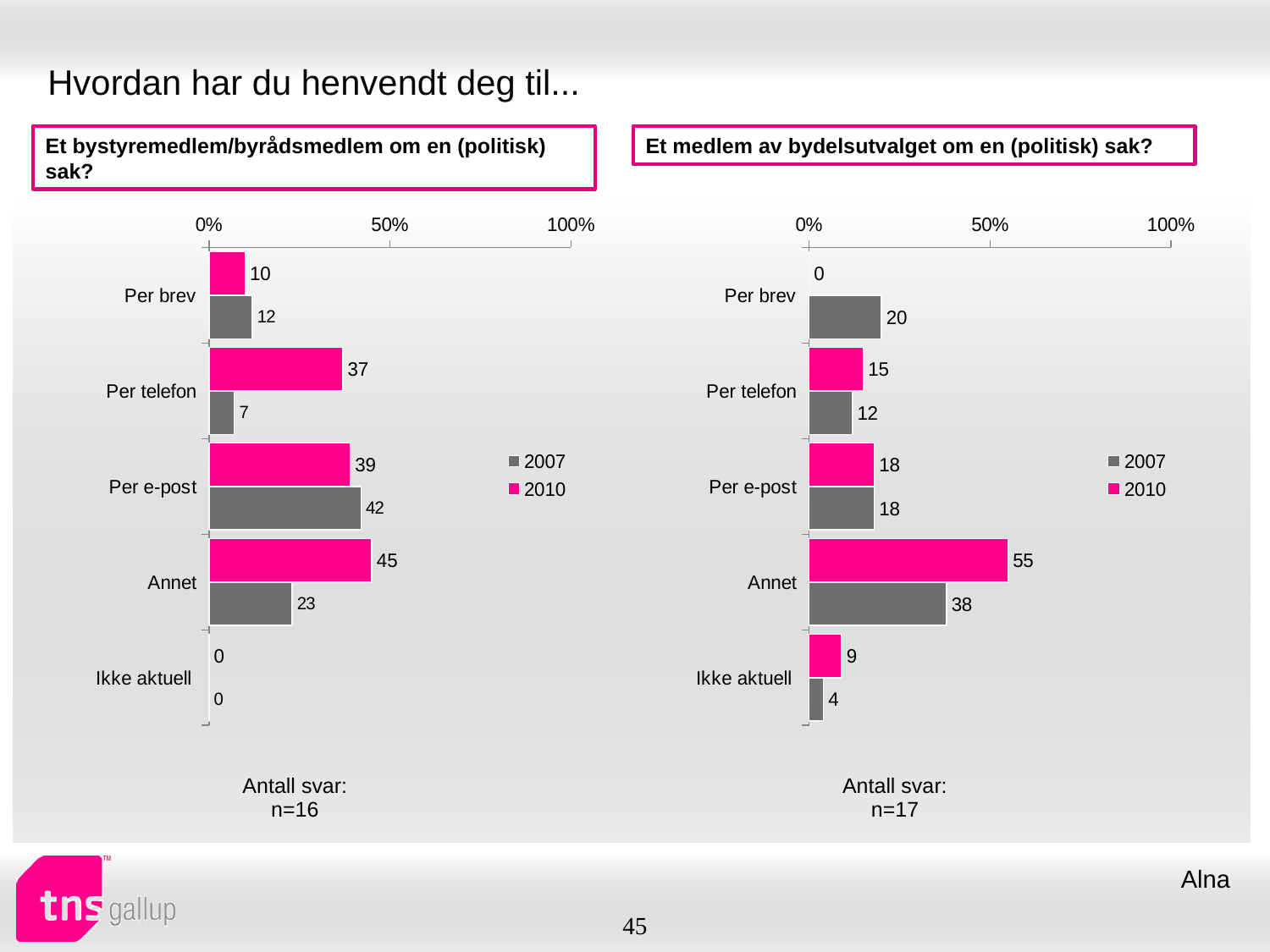
In the right chart (Et medlem av bydelsutvalget om en (politisk) sak?), what is the value for Annet in 2010? 55 How many series does the legend of the left chart (Et bystyremedlem/byrådsmedlem om en (politisk) sak?) list? 2 In the left chart (Et bystyremedlem/byrådsmedlem om en (politisk) sak?), what is the difference between the 2010 and 2007 values for Annet? 22 In the right chart (Et medlem av bydelsutvalget om en (politisk) sak?), is the 2010 value for Annet greater or less than 50%? greater In the left chart (Et bystyremedlem/byrådsmedlem om en (politisk) sak?), which category has the highest value for 2010? Annet What type of chart is the right chart (Et medlem av bydelsutvalget om en (politisk) sak?)? Bar chart In the left chart (Et bystyremedlem/byrådsmedlem om en (politisk) sak?), how many categories are shown on the vertical axis? 5 In the right chart (Et medlem av bydelsutvalget om en (politisk) sak?), what is the value for Per brev in 2007? 20 In the left chart (Et bystyremedlem/byrådsmedlem om en (politisk) sak?), what is the value for Per e-post in 2007? 42 In the right chart (Et medlem av bydelsutvalget om en (politisk) sak?), which category has the lowest value for 2007? Ikke aktuell In the left chart (Et bystyremedlem/byrådsmedlem om en (politisk) sak?), what is the value for Per telefon in 2010? 37 In the right chart (Et medlem av bydelsutvalget om en (politisk) sak?), which is larger for Per telefon: the 2007 value or the 2010 value? 2010